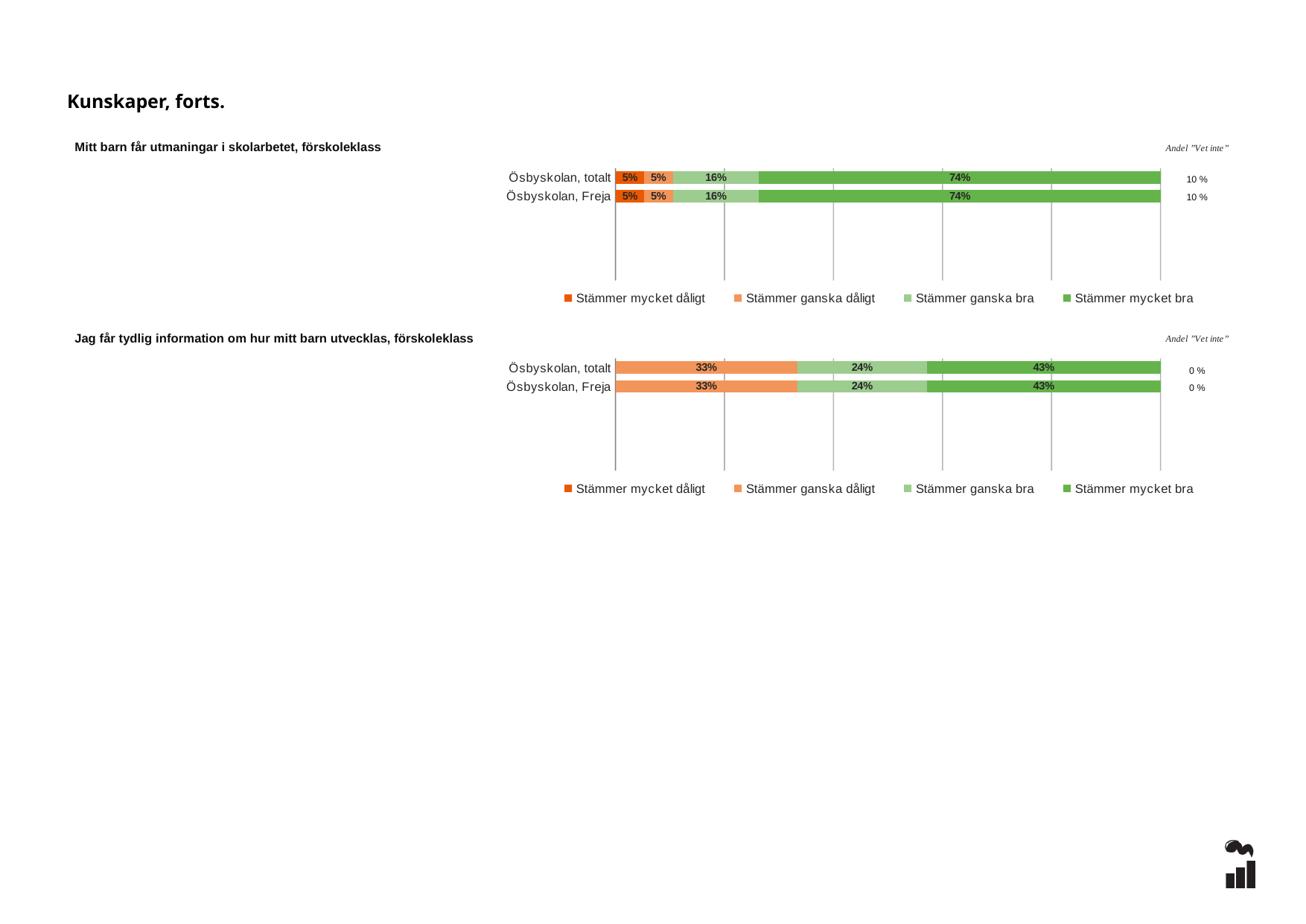
How many categories (rows) are shown in the chart 'Jag får tydlig information om hur mitt barn utvecklas, förskoleklass'? 2 In the chart 'Jag får tydlig information om hur mitt barn utvecklas, förskoleklass', what is the value of 'Stämmer mycket bra' for Ösbyskolan, Freja? 43% In the chart 'Jag får tydlig information om hur mitt barn utvecklas, förskoleklass', what is the value of 'Stämmer ganska dåligt' for Ösbyskolan, totalt? 33% What kind of chart is 'Mitt barn får utmaningar i skolarbetet, förskoleklass'? Stacked bar chart In the chart 'Mitt barn får utmaningar i skolarbetet, förskoleklass', what is the difference between 'Stämmer mycket bra' and 'Stämmer ganska bra' for Ösbyskolan, Freja? 58% In the chart 'Jag får tydlig information om hur mitt barn utvecklas, förskoleklass', which response category has the highest value for Ösbyskolan, totalt? Stämmer mycket bra In the chart 'Mitt barn får utmaningar i skolarbetet, förskoleklass', what is the value of 'Stämmer ganska bra' for Ösbyskolan, Freja? 16% In the chart 'Mitt barn får utmaningar i skolarbetet, förskoleklass', what is the value of 'Stämmer mycket dåligt' for Ösbyskolan, totalt? 5% In the chart 'Jag får tydlig information om hur mitt barn utvecklas, förskoleklass', what is the 'Andel "Vet inte"' value shown for Ösbyskolan, totalt? 0 % How many series does the legend of the chart 'Mitt barn får utmaningar i skolarbetet, förskoleklass' list? 4 In the chart 'Jag får tydlig information om hur mitt barn utvecklas, förskoleklass', which is larger for Ösbyskolan, totalt: 'Stämmer ganska dåligt' or 'Stämmer ganska bra'? Stämmer ganska dåligt In the chart 'Mitt barn får utmaningar i skolarbetet, förskoleklass', what is the value of 'Stämmer mycket bra' for Ösbyskolan, totalt? 74%